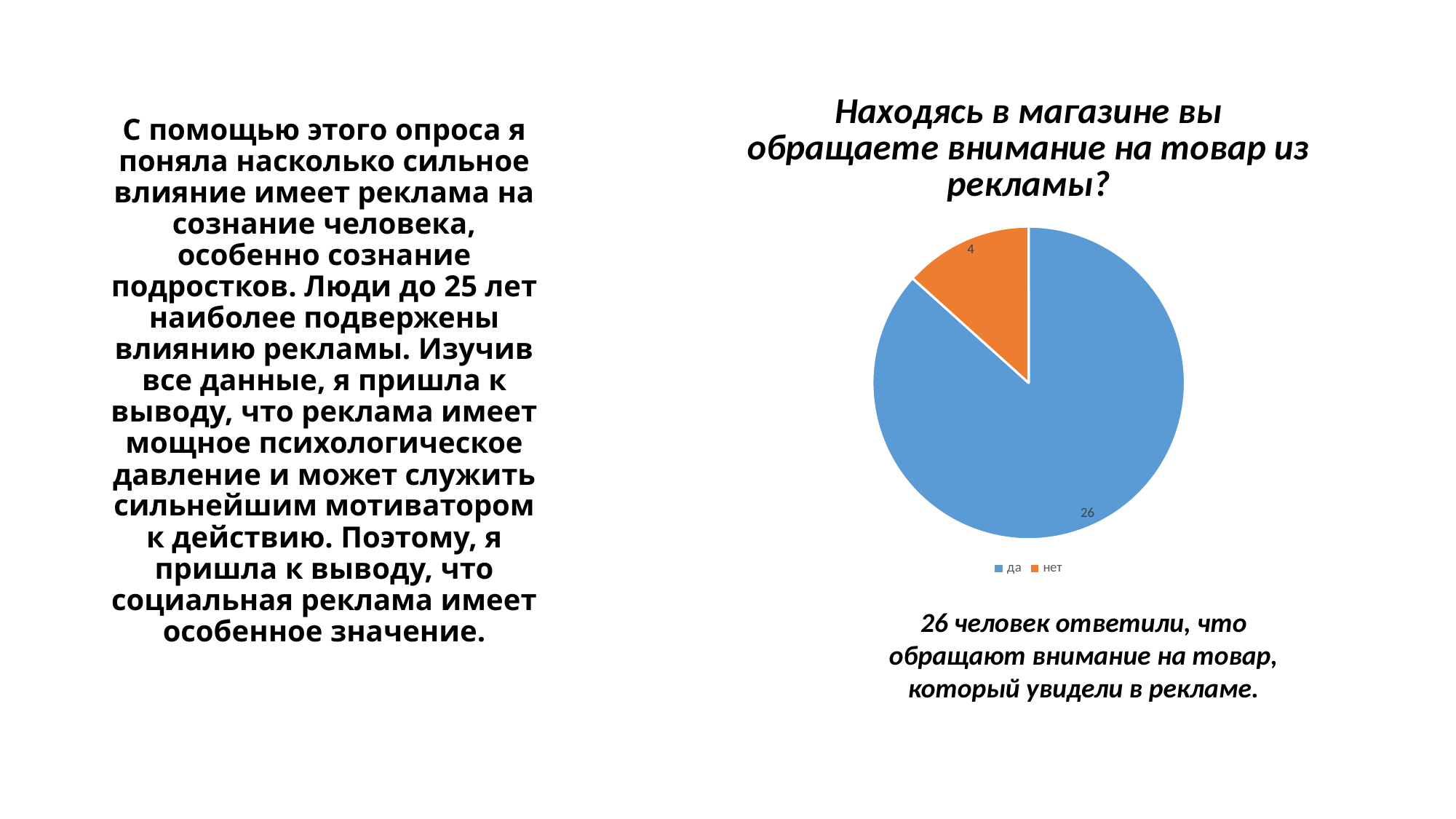
Which category has the largest slice in the pie chart? да What is the difference between the values for "да" and "нет"? 22 What is the total of all slices in the pie chart? 30 What is the title of the pie chart? Находясь в магазине вы обращаете внимание на товар из рекламы? Which category has the smallest slice in the pie chart? нет How many entries does the legend list? 2 What kind of chart is shown on the slide? pie chart How many categories does the pie chart have? 2 What is the value for "да" in the pie chart? 26 Which is larger, the value for "да" or the value for "нет"? да What colour is the "нет" slice in the pie chart? orange What is the value for "нет" in the pie chart? 4